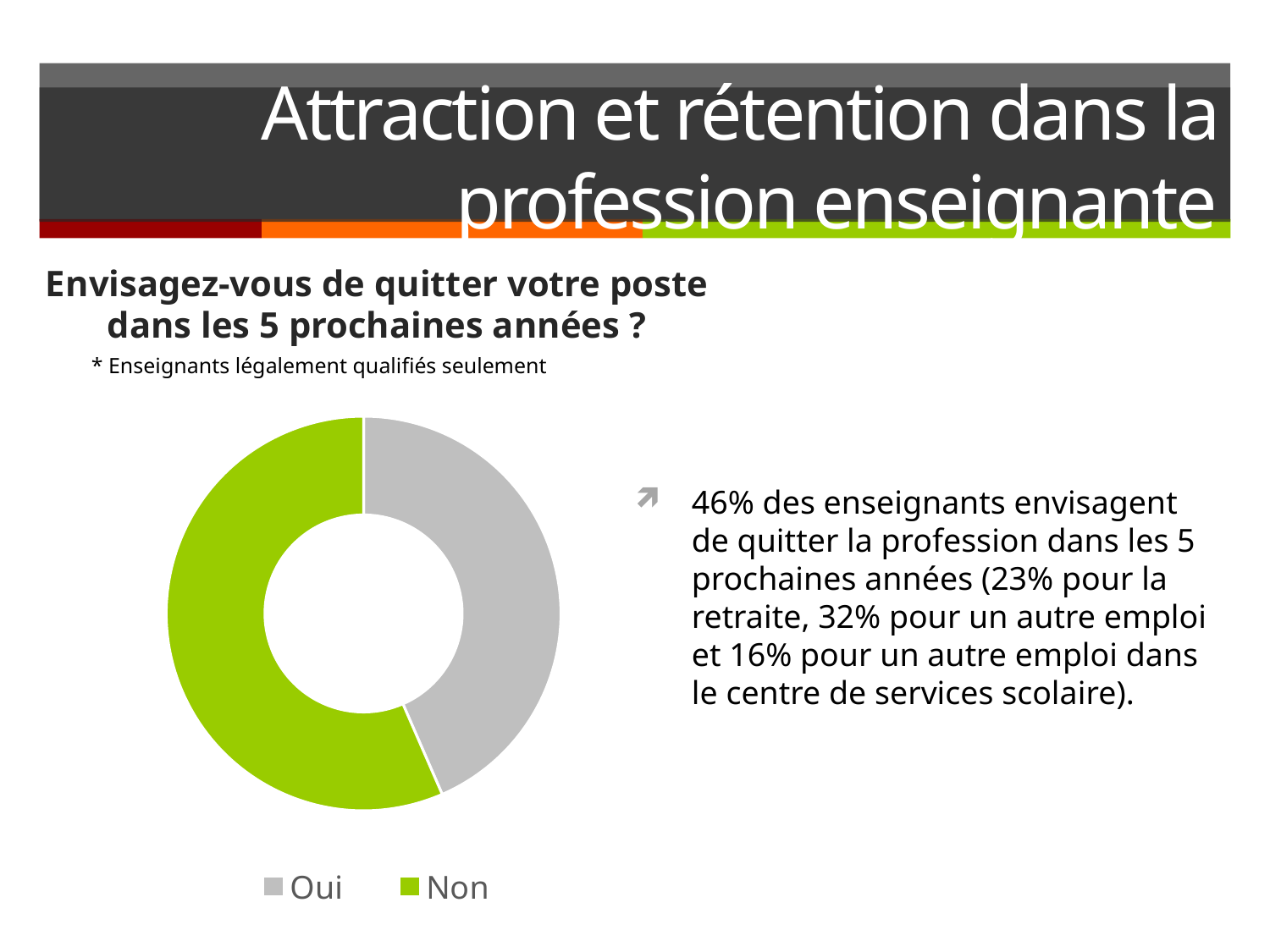
Which category has the largest slice in the donut chart? Non What colour represents the 'Non' category in the donut chart? Green What survey question does the donut chart illustrate? Envisagez-vous de quitter votre poste dans les 5 prochaines années ? Which slice is larger in the donut chart, Oui or Non? Non Which category has the smallest slice in the donut chart? Oui How many entries does the legend of the donut chart list? 2 How many categories does the donut chart show? 2 What kind of chart is shown on the slide? Donut (pie) chart